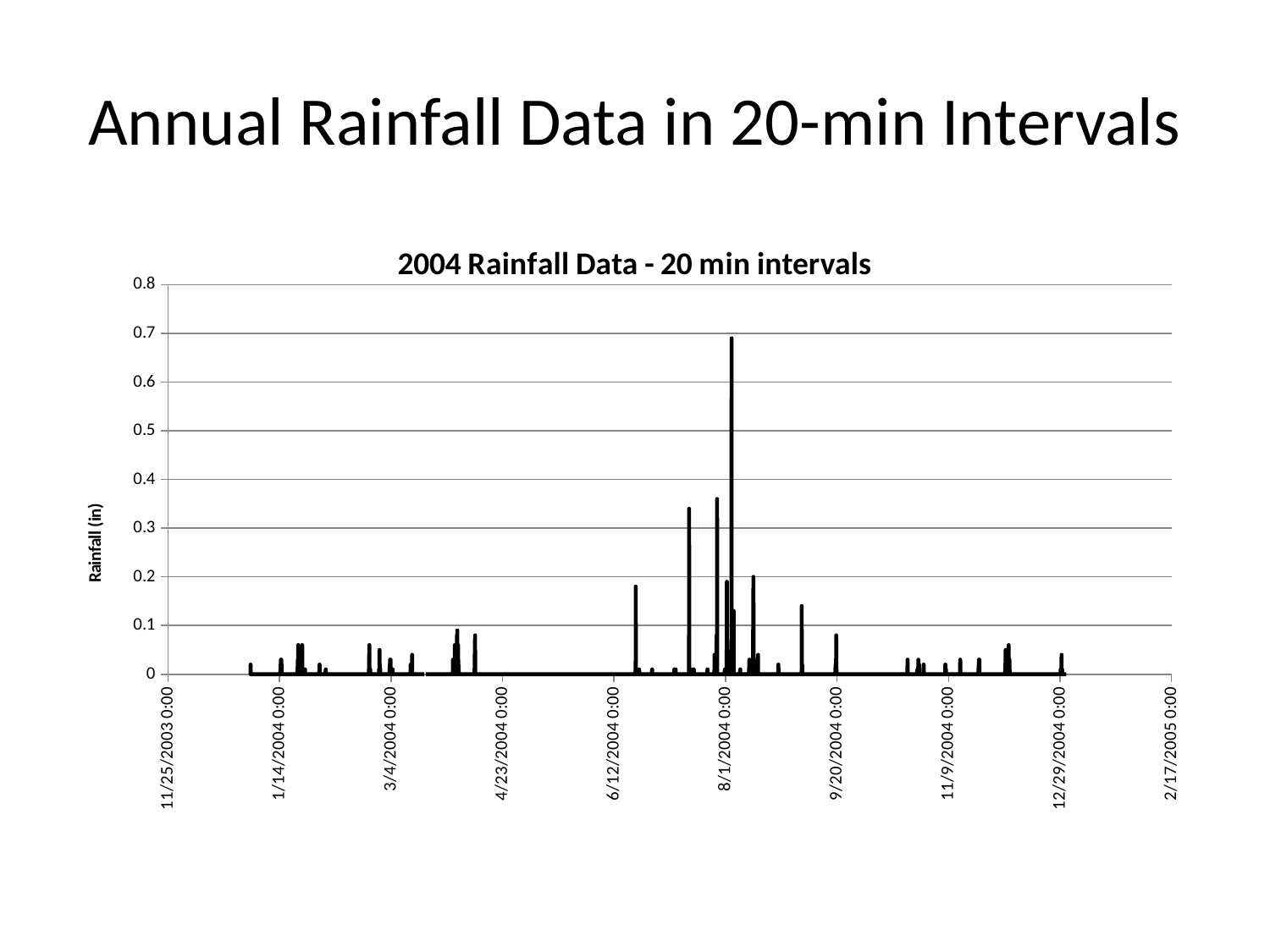
What is the title of the chart? 2004 Rainfall Data - 20 min intervals What is the highest value shown on the vertical axis? 0.8 Is the highest rainfall value plotted on the chart greater or less than 0.6? greater Is the rainfall spike just after the 9/20/2004 0:00 tick greater or less than 0.1? less Is the rainfall spike just after the 6/12/2004 0:00 tick greater or less than 0.1? greater What kind of chart is shown on the slide? line chart How many date labels are shown along the horizontal axis? 10 What is the label on the vertical axis of the chart? Rainfall (in) Near which x-axis date label does the highest rainfall spike occur? 8/1/2004 0:00 Which period has the larger rainfall spikes: around 8/1/2004 0:00 or around 3/4/2004 0:00? around 8/1/2004 0:00